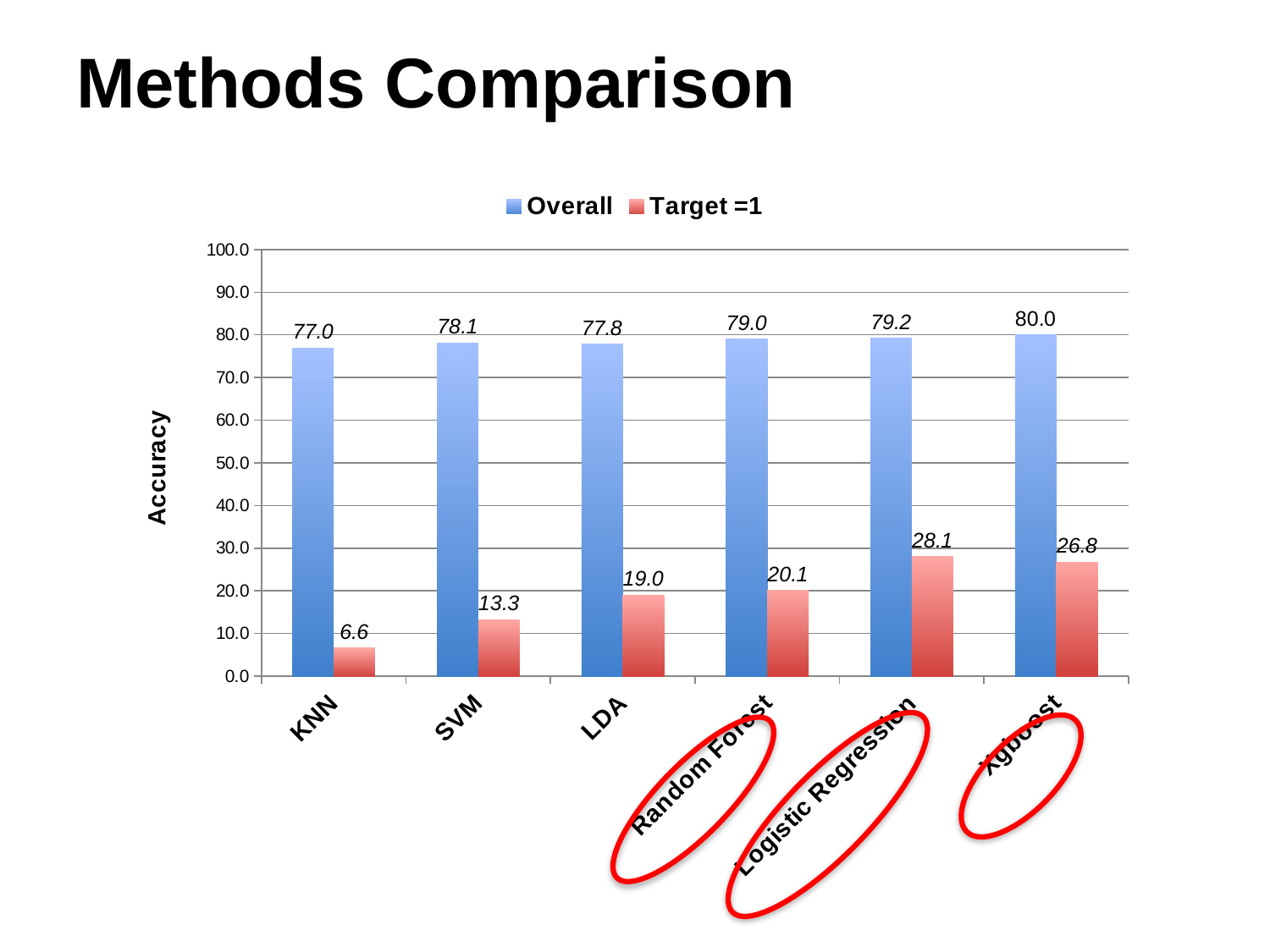
Do the Target =1 values rise or fall from KNN to Logistic Regression? Rise How many methods are compared on the x axis? 6 What is the Overall accuracy for KNN? 77.0 Which method has the highest Overall accuracy? Xgboost Which has a higher Target =1 accuracy, LDA or Random Forest? Random Forest Which method has the lowest Target =1 accuracy? KNN What is the Target =1 accuracy for Logistic Regression? 28.1 What is the difference between the Overall accuracy and the Target =1 accuracy for SVM? 64.8 How many series does the legend list? 2 What kind of chart is shown on the slide? Bar chart What is the Target =1 accuracy for Xgboost? 26.8 What is the label of the y axis? Accuracy